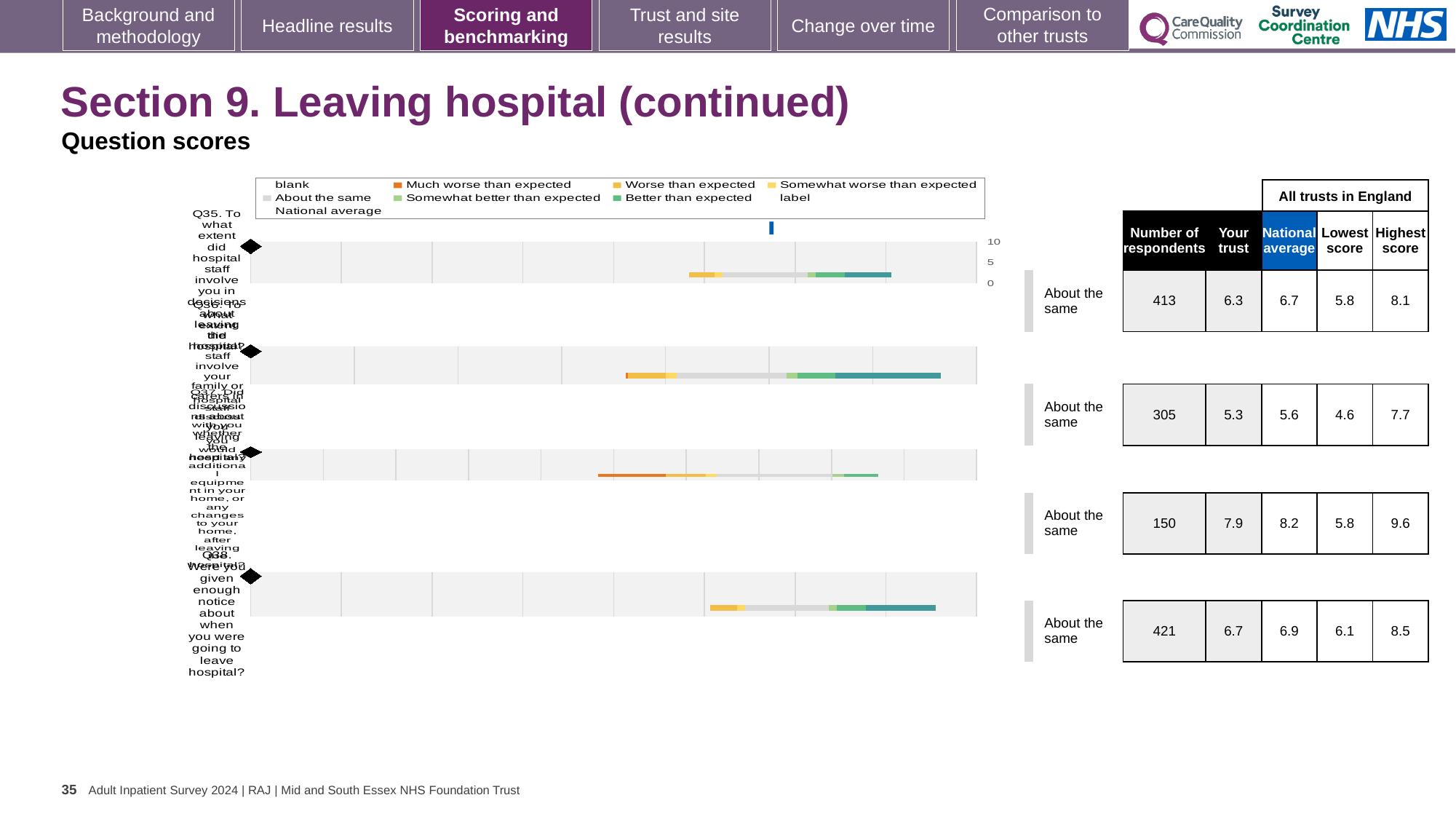
In the table, what is the national average for the third row (Q37)? 8.2 What kind of chart is shown on the slide? bar chart In the chart legend, which colour represents 'Much worse than expected'? orange How many question rows (bars) does the chart show? 4 What benchmark category is shown next to every bar in the chart? About the same Is the 'Your trust' score larger for Q35 (first row) or Q38 (last row)? Q38 In the table, what is the lowest score for the second row (Q36)? 4.6 In the table, what is the 'Your trust' score for Q38 (the last row)? 6.7 In the table, what is the number of respondents for Q35 (the first row)? 413 Which row has the fewest respondents in the table? Q37 (third row), 150 What is the difference between the highest score and the lowest score for Q35 (the first row)? 2.3 Which row has the highest 'Your trust' score in the table? Q37 (third row), 7.9